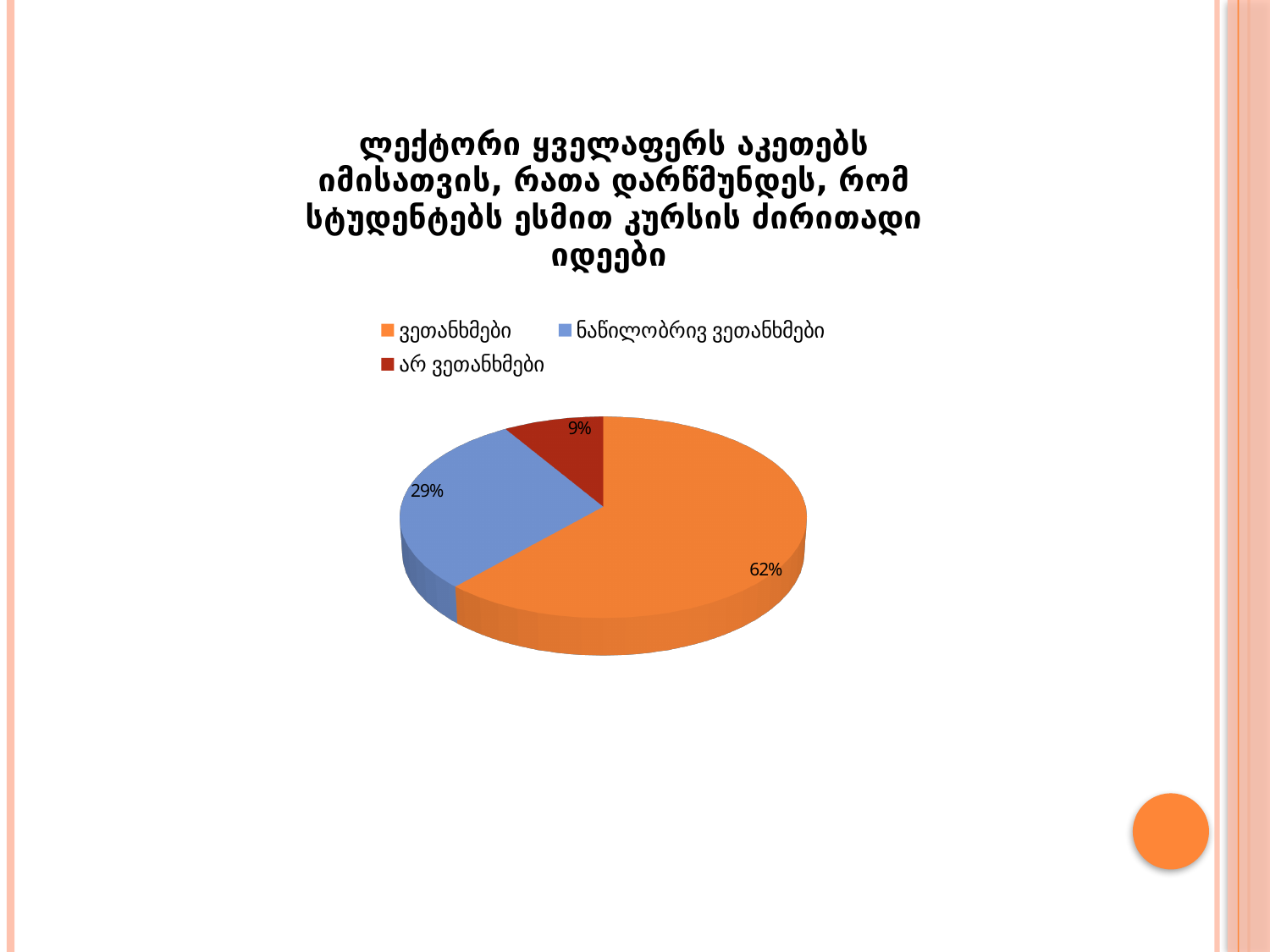
What percentage of the pie is labelled ვეთანხმები? 62% Which category has the smallest share of the pie? არ ვეთანხმები What is the difference in percentage points between ვეთანხმები and ნაწილობრივ ვეთანხმები? 33 Which is larger, the share for ნაწილობრივ ვეთანხმები or the share for არ ვეთანხმები? ნაწილობრივ ვეთანხმები What percentage of the pie is labelled ნაწილობრივ ვეთანხმები? 29% What percentage of the pie is labelled არ ვეთანხმები? 9% Which category has the largest share of the pie? ვეთანხმები How many slices does the pie chart have? 3 What colour is the slice for ნაწილობრივ ვეთანხმები? Blue What kind of chart is shown on the slide? Pie chart What is the difference in percentage points between ნაწილობრივ ვეთანხმები and არ ვეთანხმები? 20 How many entries does the legend list? 3